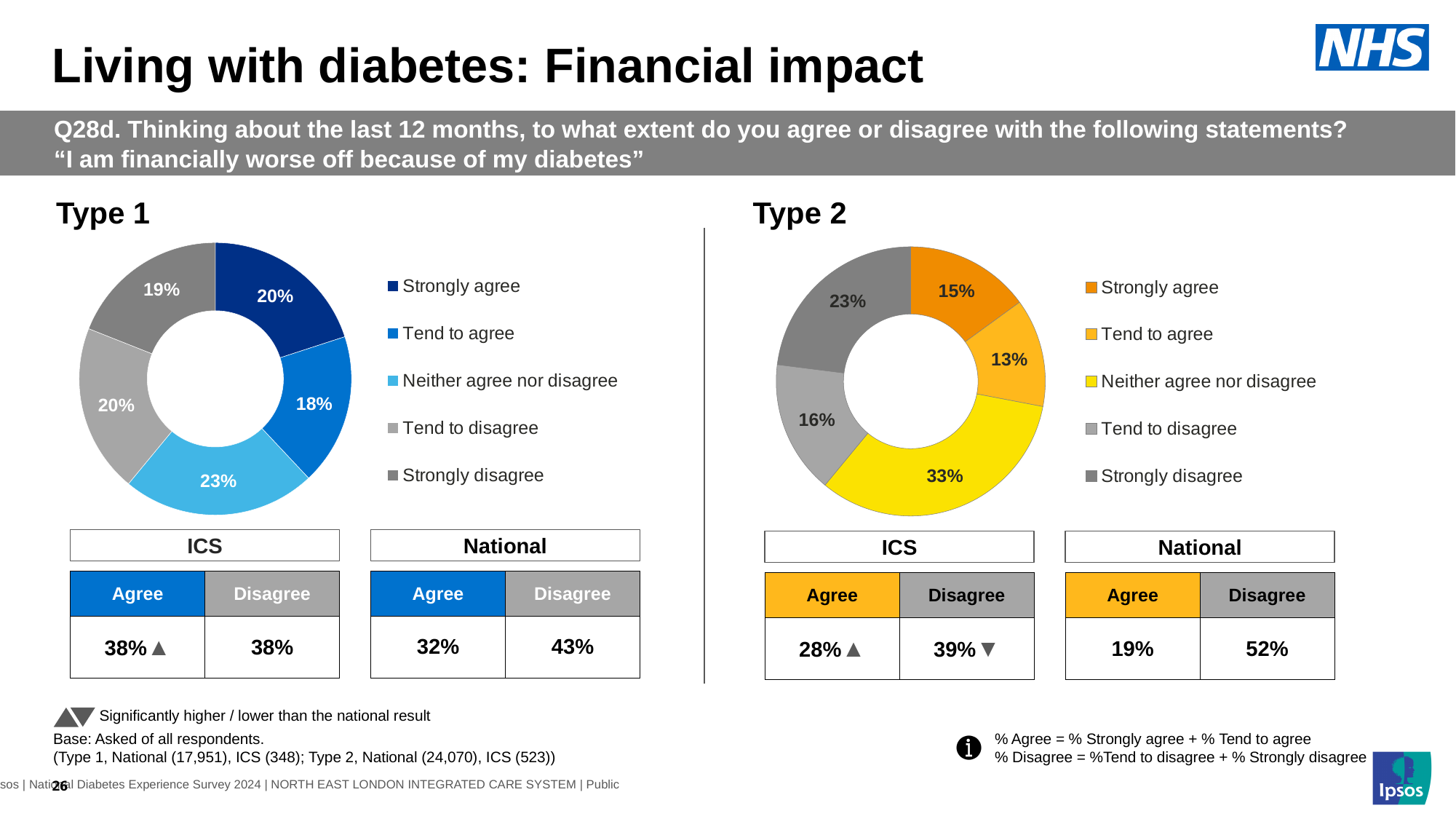
In the Type 2 chart, what percentage of respondents said they tend to agree? 13% In the Type 2 chart, what colour represents 'Neither agree nor disagree'? Yellow In the Type 1 chart, what percentage of respondents said they strongly agree? 20% What kind of chart is used to show the Type 1 results? Donut (pie) chart How many response categories does the Type 2 chart's legend list? 5 In the Type 2 chart, what is the difference in percentage points between 'Neither agree nor disagree' and 'Strongly disagree'? 10 percentage points In the Type 2 chart, which response category has the largest share? Neither agree nor disagree In the Type 2 chart, what percentage of respondents said they strongly disagree? 23% In the Type 1 chart, which is larger: the share for 'Tend to agree' or the share for 'Tend to disagree'? Tend to disagree In the Type 2 chart, which response category has the smallest share? Tend to agree In the Type 1 chart, what percentage of respondents said they neither agree nor disagree? 23% In the Type 1 chart, which response category has the largest share? Neither agree nor disagree